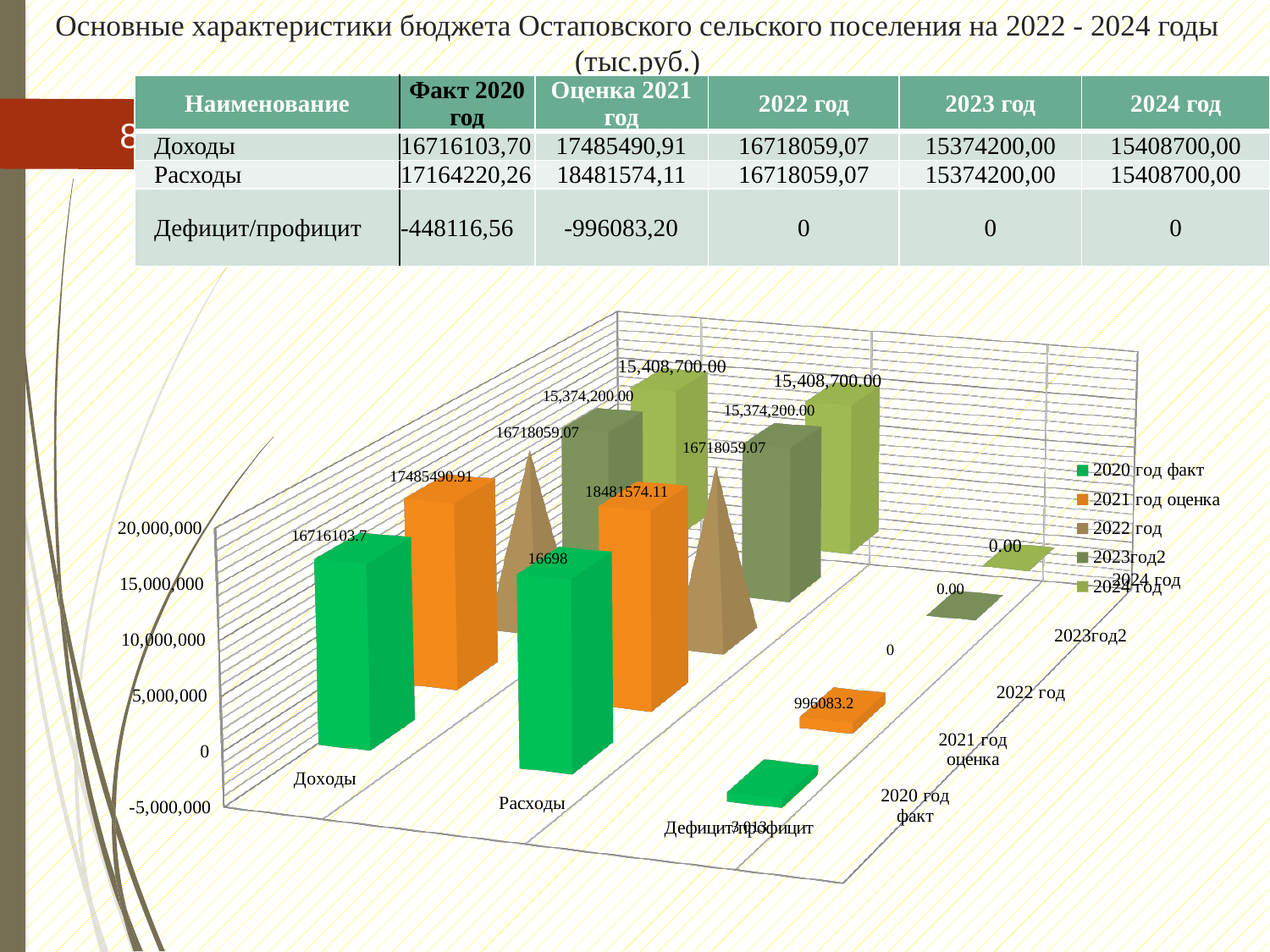
What kind of chart is shown on the slide? bar chart How many series does the chart legend list? 5 Which is larger for Доходы: the 2020 год факт value or the 2021 год оценка value? 2021 год оценка Which series has the highest value for Расходы? 2021 год оценка What is the value labelled for Доходы in the 2020 год факт series? 16716103.7 How many categories are plotted along the x axis of the chart? 3 Which colour represents the 2021 год оценка series in the legend? orange What is the value labelled for Доходы in the 2024 год series? 15,408,700.00 What is the value labelled for Расходы in the 2021 год оценка series? 18481574.11 Is the value for Доходы in the 2020 год факт series greater or less than 15,000,000? greater What is the difference between the 2024 год and 2023год2 values for Доходы? 34,500.00 What is the value labelled for Доходы in the 2022 год series? 16718059.07